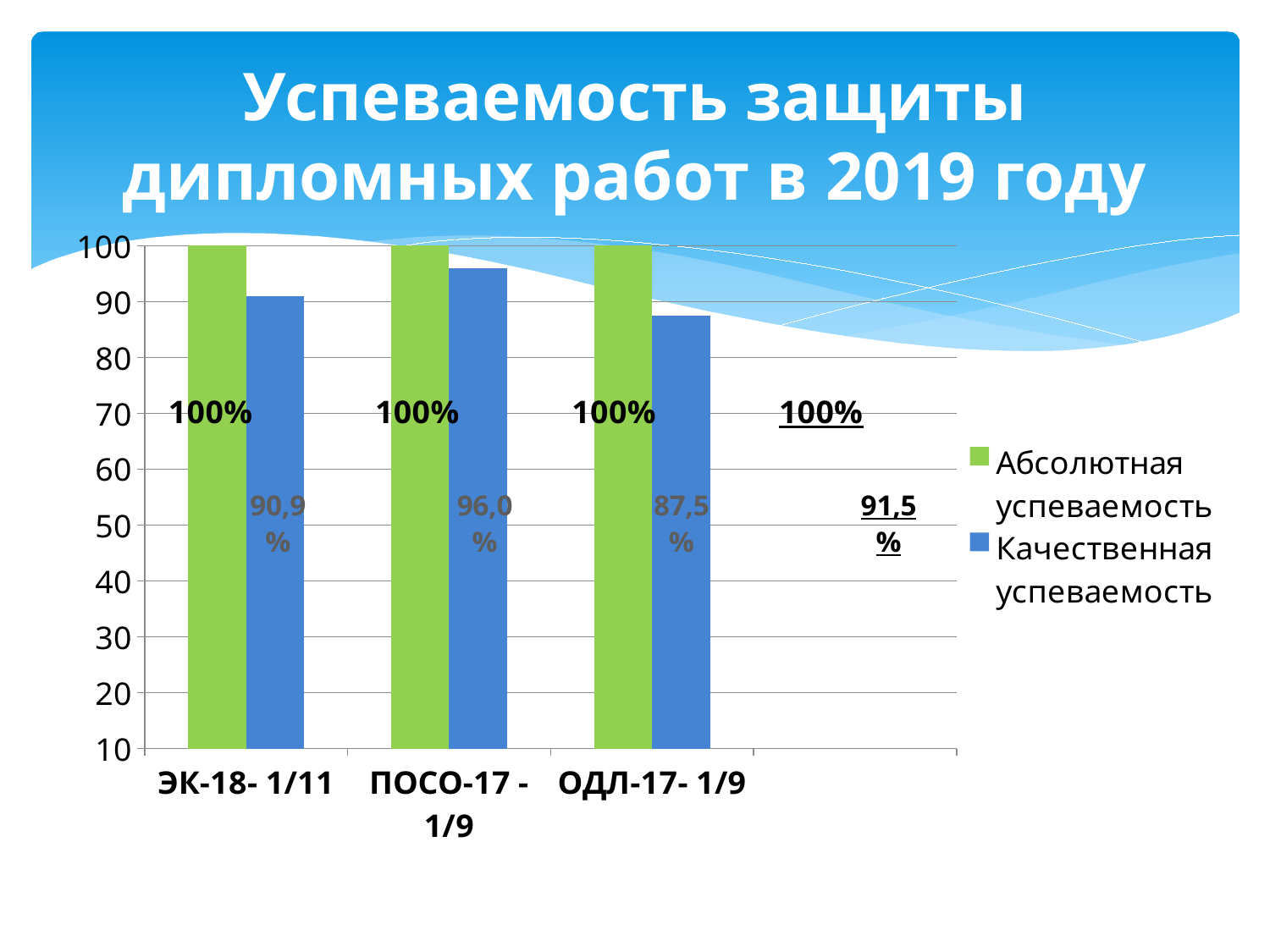
What is the value of Абсолютная успеваемость for ОДЛ-17- 1/9? 100% What is the value of Качественная успеваемость for ЭК-18- 1/11? 90,9% Which category has the lowest Качественная успеваемость? ОДЛ-17- 1/9 Which category has the highest Качественная успеваемость? ПОСО-17 - 1/9 What is the difference between the Качественная успеваемость values for ПОСО-17 - 1/9 and ОДЛ-17- 1/9? 8,5% What is the value of Качественная успеваемость for ПОСО-17 - 1/9? 96,0% What is the difference between Абсолютная успеваемость and Качественная успеваемость for ЭК-18- 1/11? 9,1% What is the value of Качественная успеваемость for ОДЛ-17- 1/9? 87,5% How many series does the legend list? 2 How many labelled categories are shown on the x axis? 3 Which has the larger Качественная успеваемость, ЭК-18- 1/11 or ОДЛ-17- 1/9? ЭК-18- 1/11 What kind of chart is shown on the slide? Bar chart